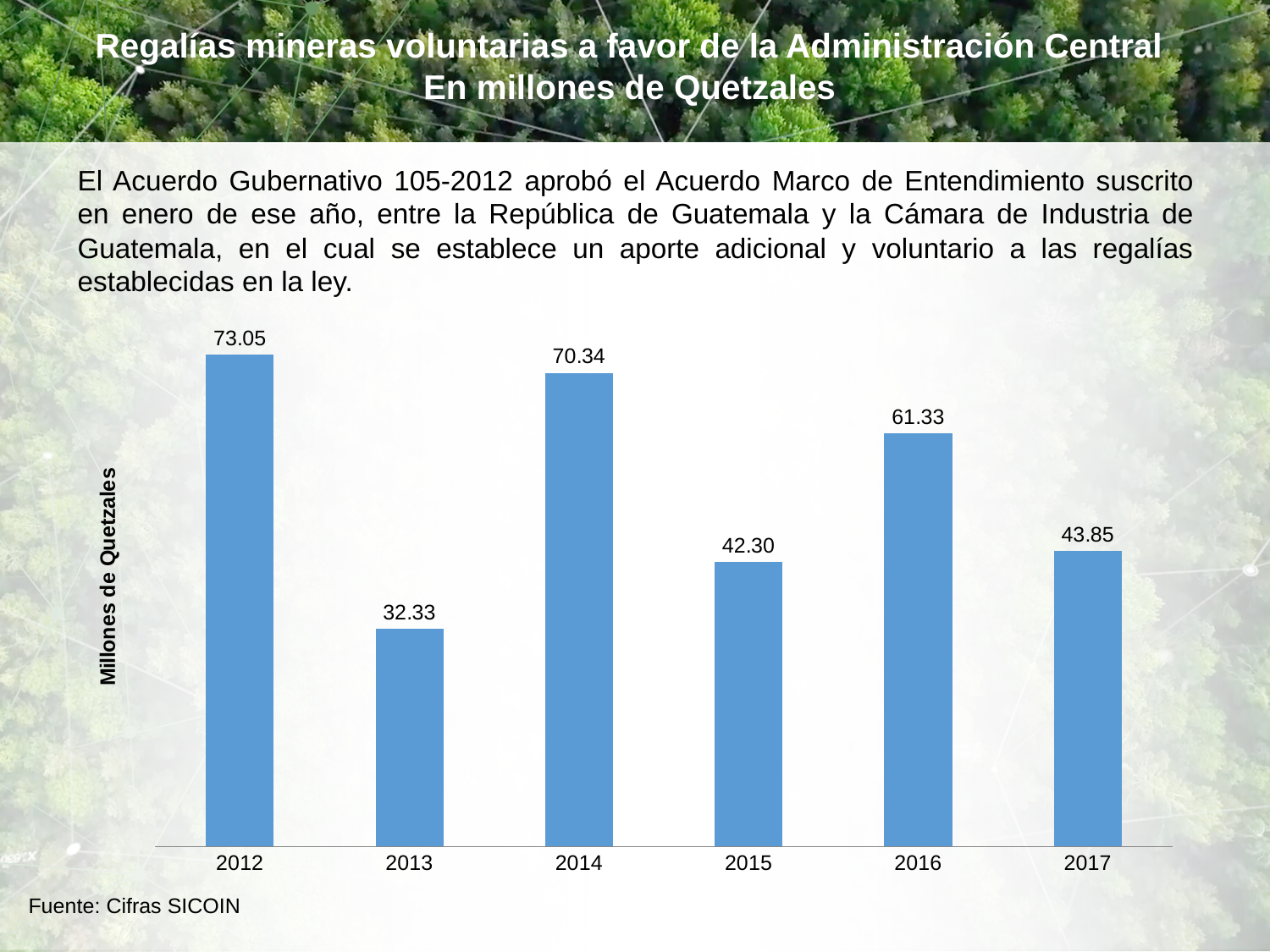
How many years are shown on the x axis? 6 Which year has the highest value? 2012 Which is larger, the value for 2014 or the value for 2016? 2014 What is the value for 2012? 73.05 Which year has the lowest value? 2013 What is the difference between the values for 2016 and 2017? 17.48 What is the label of the vertical axis? Millones de Quetzales What kind of chart is shown on the slide? bar chart What is the value for 2015? 42.30 What is the value for 2017? 43.85 Does the value rise or fall from 2012 to 2013? fall What is the difference between the values for 2014 and 2013? 38.01